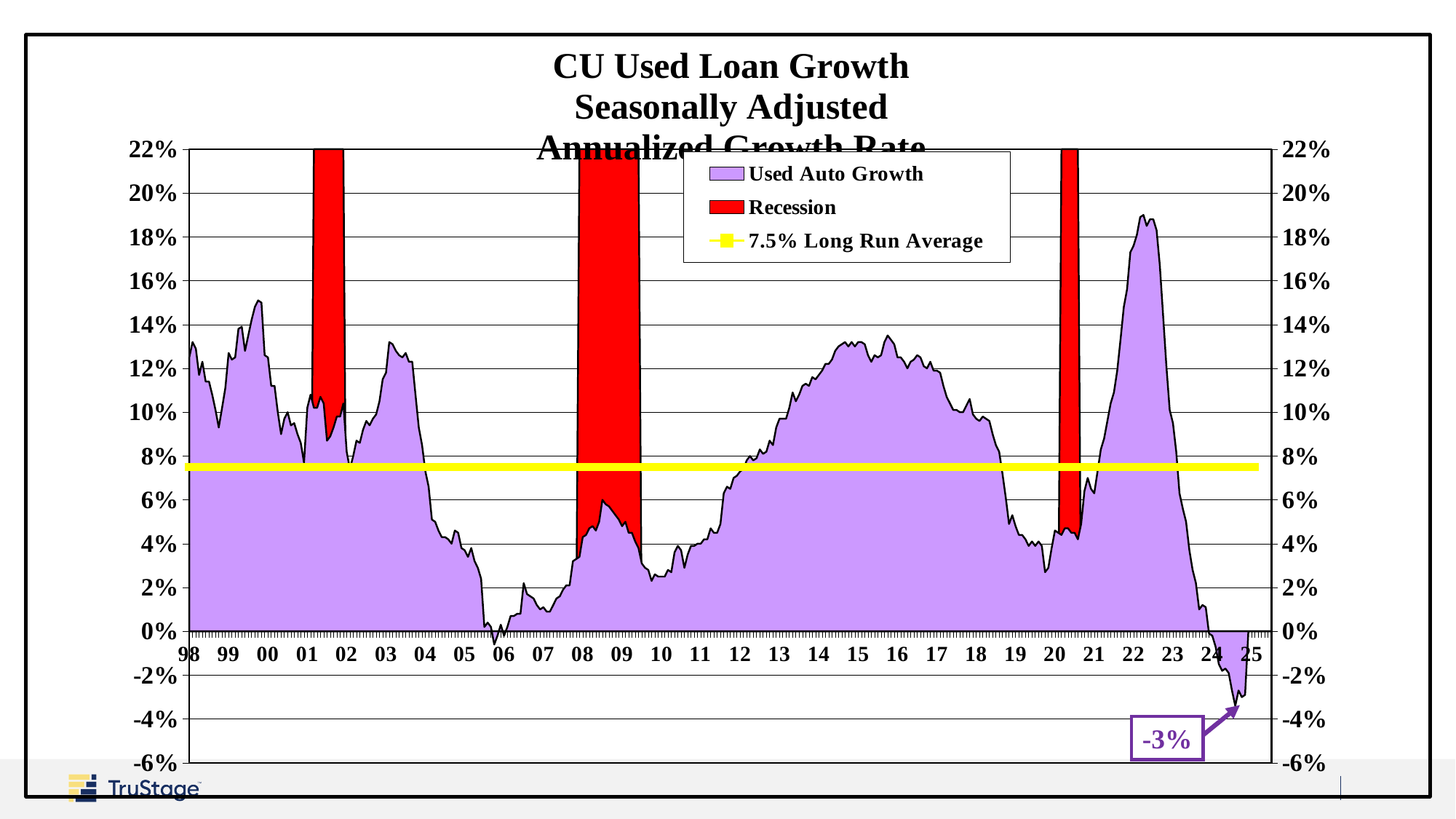
In which year does Used Auto Growth reach its lowest point? 24 How many entries does the legend list? 3 How many recession periods are shaded on the chart? 3 Is the peak value of Used Auto Growth in 2022 greater or less than 16%? greater What colour is used for the Recession series? red What is the long run average shown by the yellow line? 7.5% Does Used Auto Growth rise or fall from 2022 to 2024? fall Which is larger, the peak of Used Auto Growth around 2000 or the peak around 2022? 2022 What kind of chart is shown on the slide? area chart In which year does Used Auto Growth reach its highest peak? 22 What is the labeled value of Used Auto Growth at the end of the series in 2025? -3%